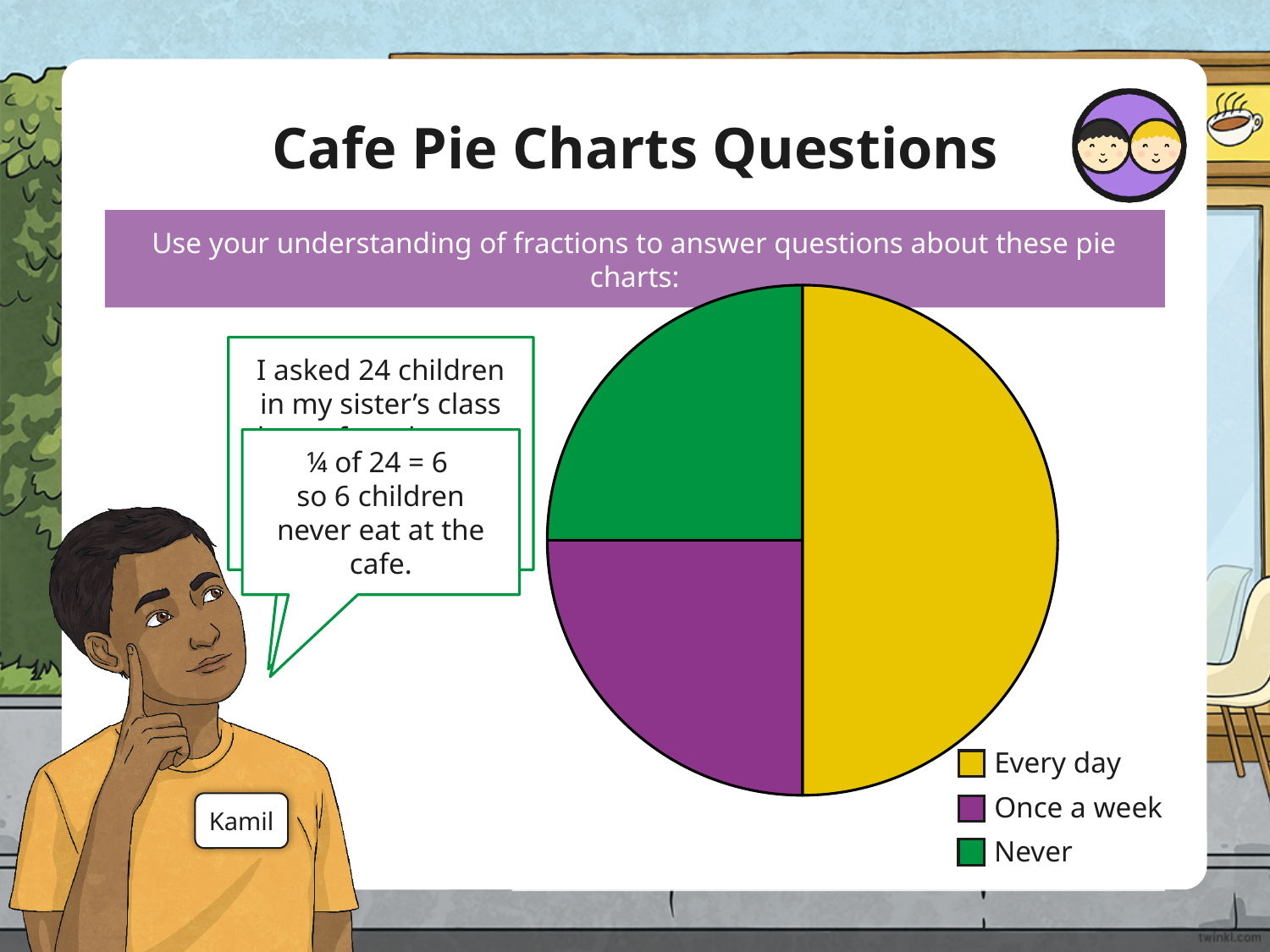
According to the slide, how many children never eat at the cafe? 6 Which category is shown in purple on the pie chart? Once a week What colour is the Every day slice of the pie chart? yellow How many slices does the pie chart have? 3 Which slice is larger, Every day or Never? Every day Which slice is larger, Every day or Once a week? Every day How many children were asked in total for the pie chart? 24 Which category takes up the largest slice of the pie chart? Every day What kind of chart is shown on the slide? pie chart How many entries does the legend of the pie chart list? 3 What fraction of the pie chart does the Never slice represent? ¼